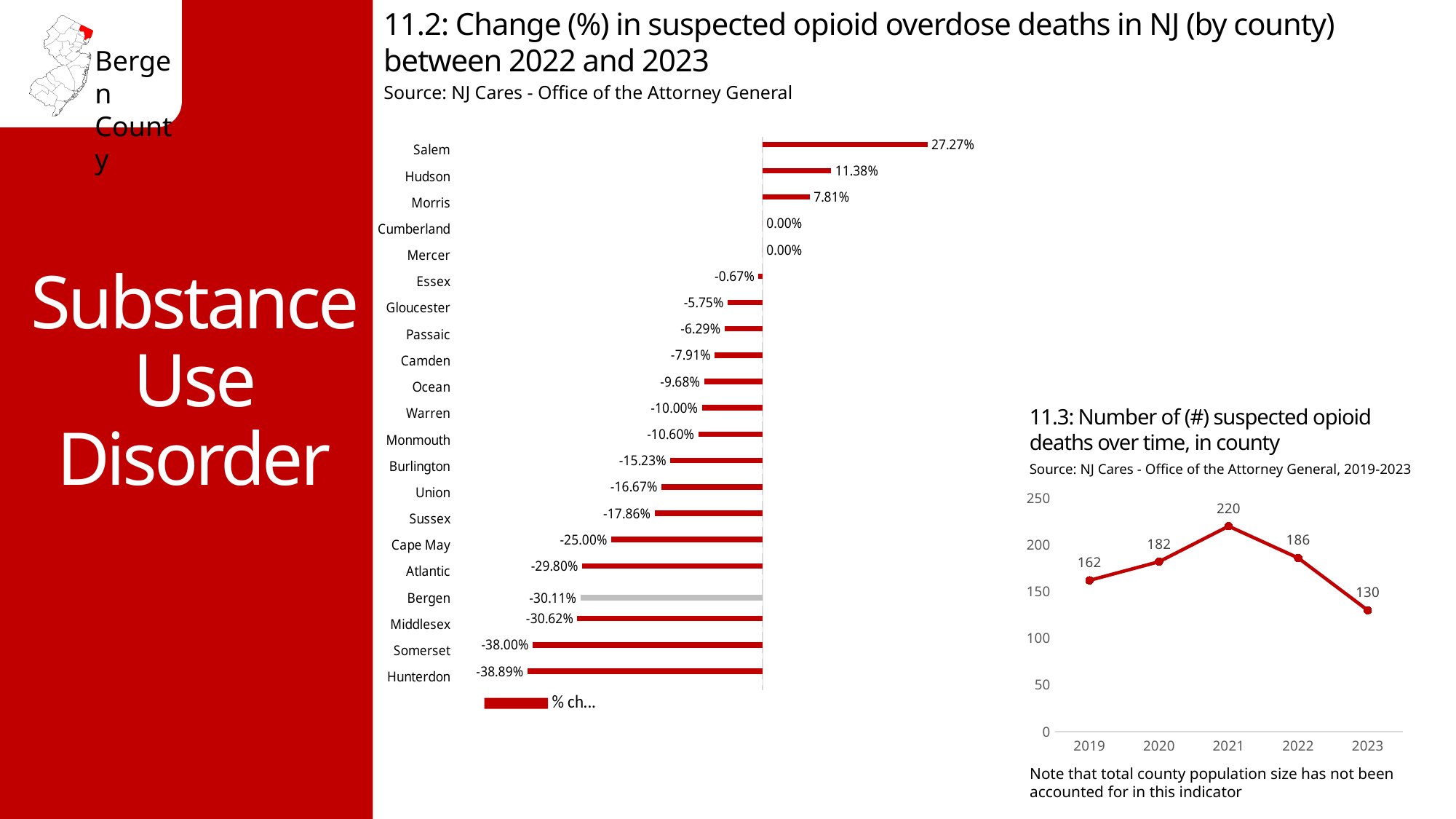
In chart 11.2 (change in suspected opioid overdose deaths by county), which is larger, the value for Atlantic or the value for Cape May? Cape May In chart 11.3 (number of suspected opioid deaths over time), which year has the lowest value? 2023 In chart 11.2 (change in suspected opioid overdose deaths by county), which county has the highest value? Salem In chart 11.3 (number of suspected opioid deaths over time), what is the value for 2021? 220 What kind of chart is chart 11.3 (number of suspected opioid deaths over time)? Line chart In chart 11.2 (change in suspected opioid overdose deaths by county), what is the value for Bergen? -30.11% In chart 11.2 (change in suspected opioid overdose deaths by county), what is the difference between the values for Hudson and Morris? 3.57% In chart 11.2 (change in suspected opioid overdose deaths by county), which county has the lowest value? Hunterdon In chart 11.3 (number of suspected opioid deaths over time), what is the difference between the values for 2022 and 2023? 56 In chart 11.2 (change in suspected opioid overdose deaths by county), how many counties are shown? 21 In chart 11.2 (change in suspected opioid overdose deaths by county), what is the value for Salem? 27.27% What kind of chart is chart 11.2 (change in suspected opioid overdose deaths by county)? Bar chart